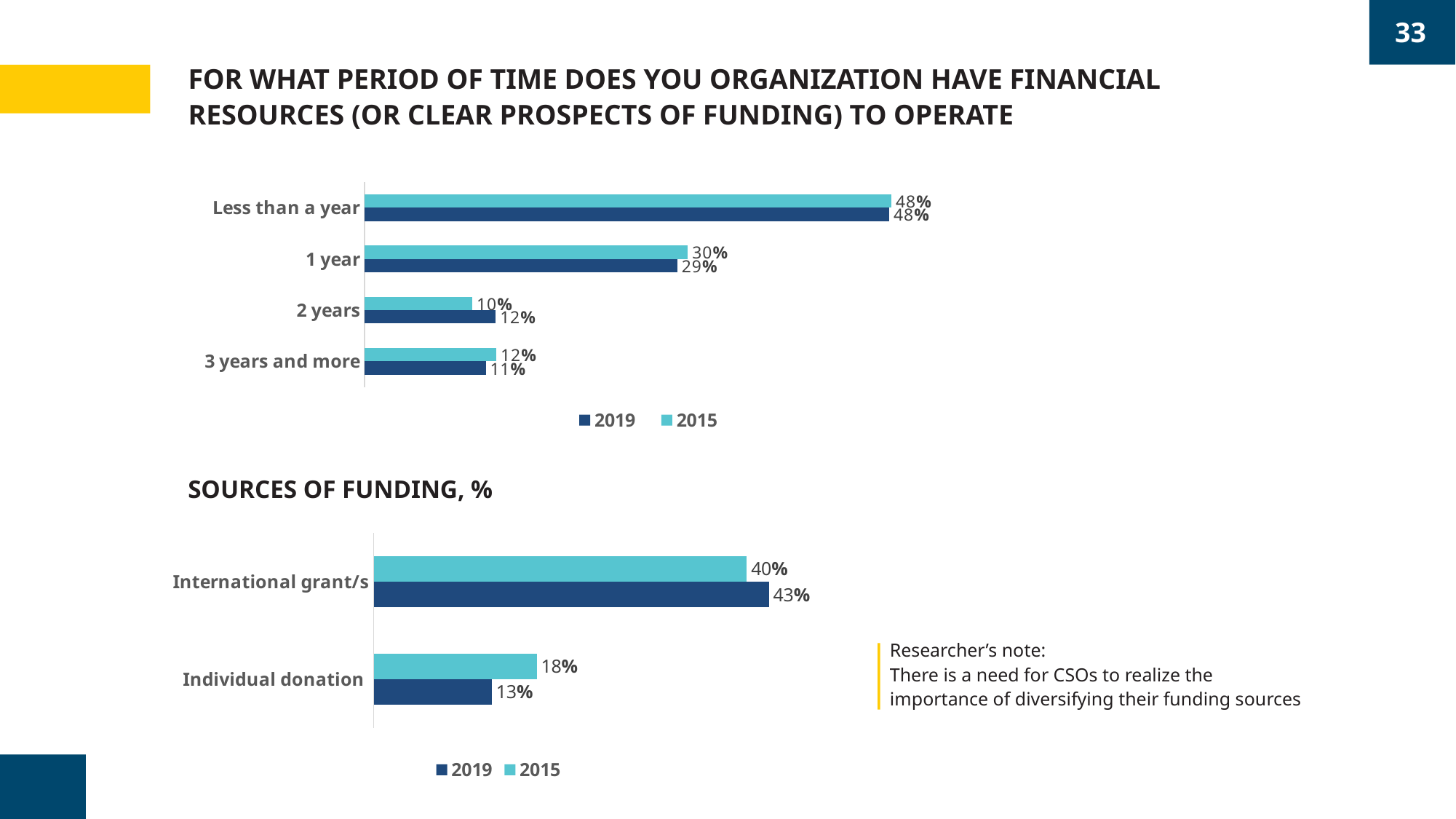
In the top chart on financial resources period, which category has the highest 2015 value? Less than a year In the top chart on financial resources period, how many categories are shown? 4 In the 'Sources of funding, %' chart, what is the difference between the 2019 and 2015 values for 'International grant/s'? 3% How many series does the legend of the 'Sources of funding, %' chart list? 2 In the top chart on financial resources period, what is the 2015 value for '1 year'? 30% In the 'Sources of funding, %' chart, what is the 2015 value for 'Individual donation'? 18% In the top chart on financial resources period, what is the 2019 value for '2 years'? 12% In the 'Sources of funding, %' chart, what is the 2019 value for 'International grant/s'? 43% In the top chart on financial resources period, which category has the lowest 2015 value? 2 years In the 'Sources of funding, %' chart, which is larger for 'Individual donation': the 2019 value or the 2015 value? 2015 In the top chart on financial resources period, what is the difference between the 2019 values for '1 year' and '3 years and more'? 18% In the top chart on financial resources period, what is the 2019 value for 'Less than a year'? 48%